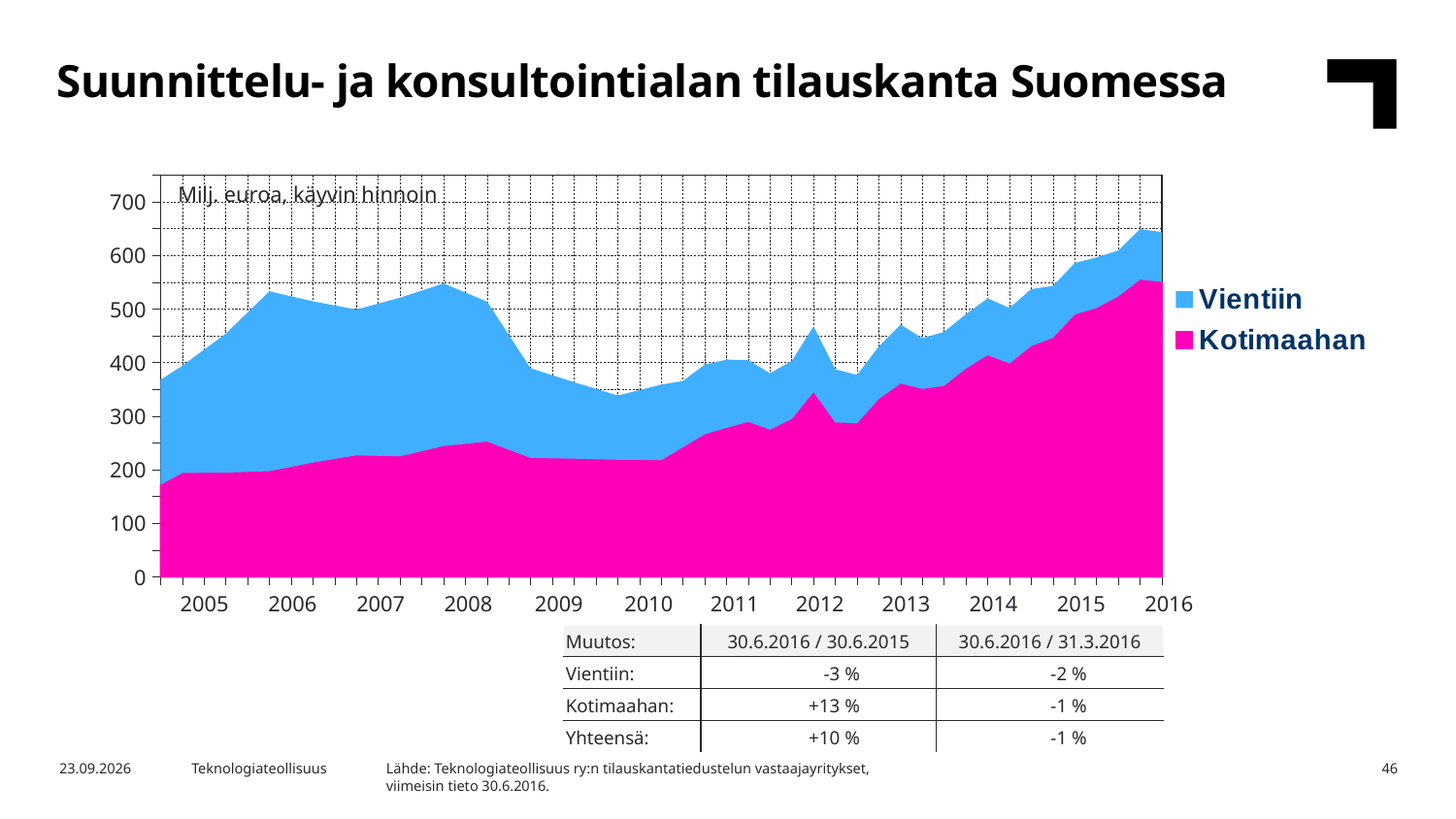
What kind of chart is shown on the slide? Stacked area chart Which series is larger at the end of 2016, Vientiin or Kotimaahan? Kotimaahan Does the total stacked value rise or fall from 2008 to 2010? fall How many series does the chart legend list? 2 Is the total stacked value (Vientiin plus Kotimaahan) at the end of 2016 greater or less than 600? greater What are the two series named in the chart legend? Vientiin and Kotimaahan What unit label is printed inside the chart area? Milj. euroa, käyvin hinnoin Is the Kotimaahan value at the end of 2016 greater or less than 500? greater How many year labels are shown on the x axis of the chart? 12 Does the Kotimaahan series generally rise or fall from 2005 to 2016? rise Is the total stacked value (Vientiin plus Kotimaahan) in 2010 greater or less than 400? less